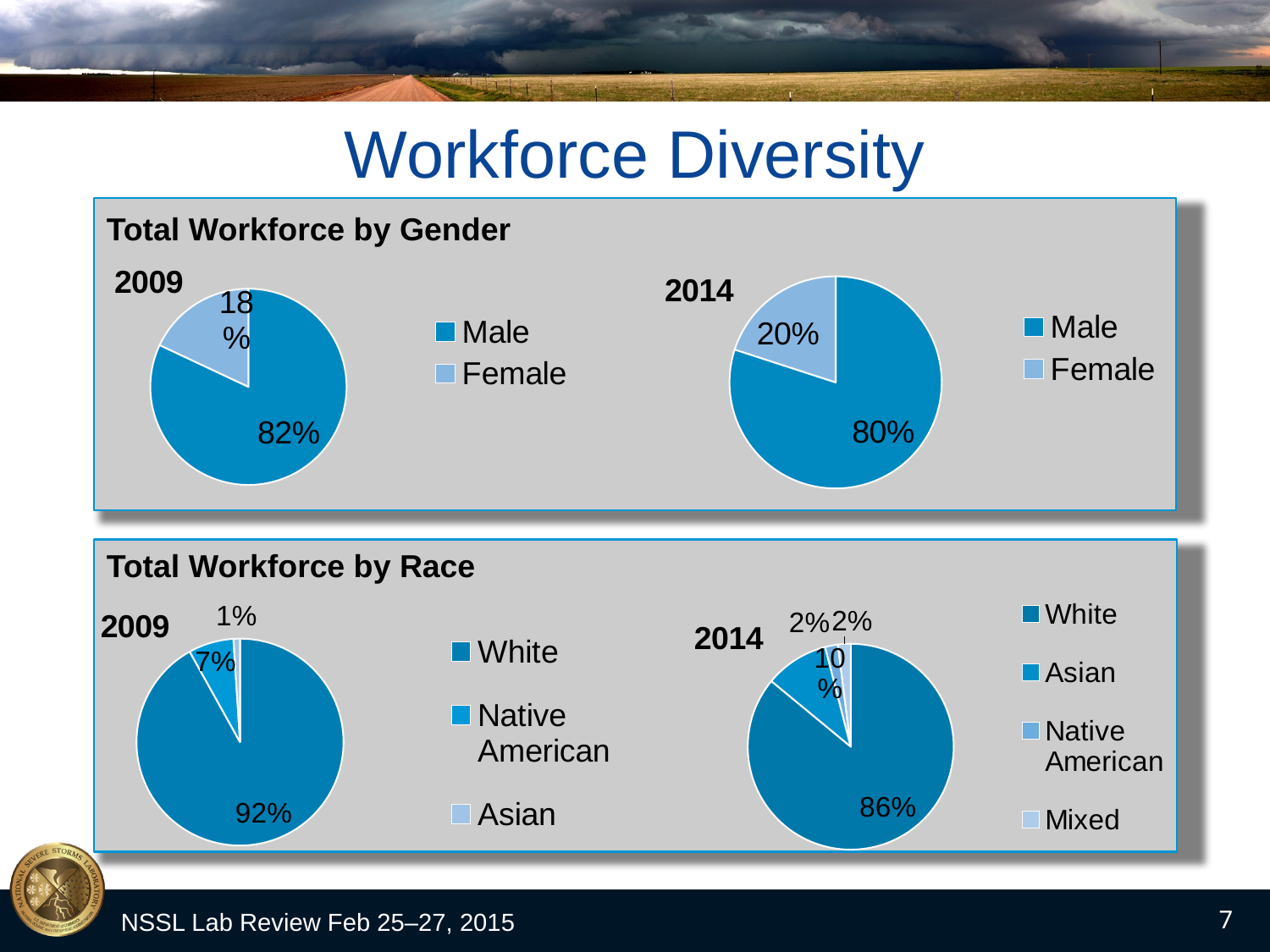
In the Total Workforce by Gender 2009 pie chart, what share of the pie is Female? 18% In the Total Workforce by Gender 2009 pie chart, what percentage of the workforce is Male? 82% How many categories does the legend of the Total Workforce by Race 2014 pie chart list? 4 Is the Female share larger in the 2009 gender pie chart or the 2014 gender pie chart? 2014 What is the difference between the Male share in the 2009 gender pie chart and the Male share in the 2014 gender pie chart? 2% In the Total Workforce by Race 2014 pie chart, what percentage of the workforce is Asian? 10% In the Total Workforce by Race 2009 pie chart, what percentage of the workforce is Native American? 7% In the Total Workforce by Gender 2014 pie chart, what percentage of the workforce is Female? 20% In the Total Workforce by Race 2014 pie chart, which category has the largest slice? White In the Total Workforce by Race 2009 pie chart, what percentage of the workforce is White? 92% In the Total Workforce by Race 2009 pie chart, which category has the smallest slice? Asian What type of chart is used in the Total Workforce by Gender section? Pie chart